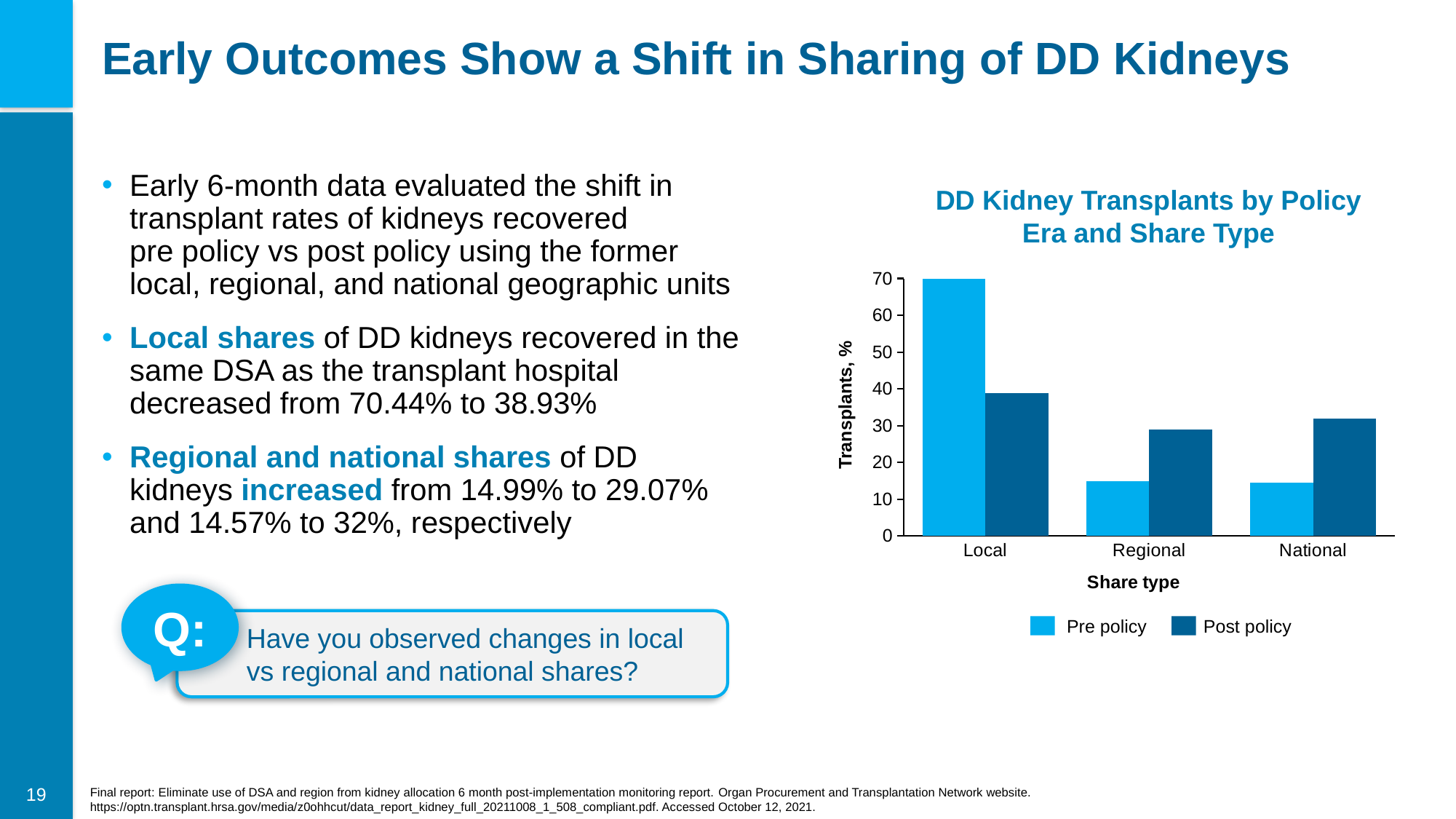
For Regional, which is larger: the Pre policy value or the Post policy value? Post policy Is the Pre policy value for Regional greater or less than 20? less Which share type has the highest Post policy value? Local Is the Pre policy value for Local greater or less than 60? greater What kind of chart is shown on the slide? bar chart How many series does the chart legend list? 2 Which share type has the highest Pre policy value? Local For Local, which is larger: the Pre policy value or the Post policy value? Pre policy For National, which is larger: the Pre policy value or the Post policy value? Post policy What is the label of the y axis of the chart? Transplants, % What is the title of the chart? DD Kidney Transplants by Policy Era and Share Type How many share types are shown on the x axis of the chart? 3